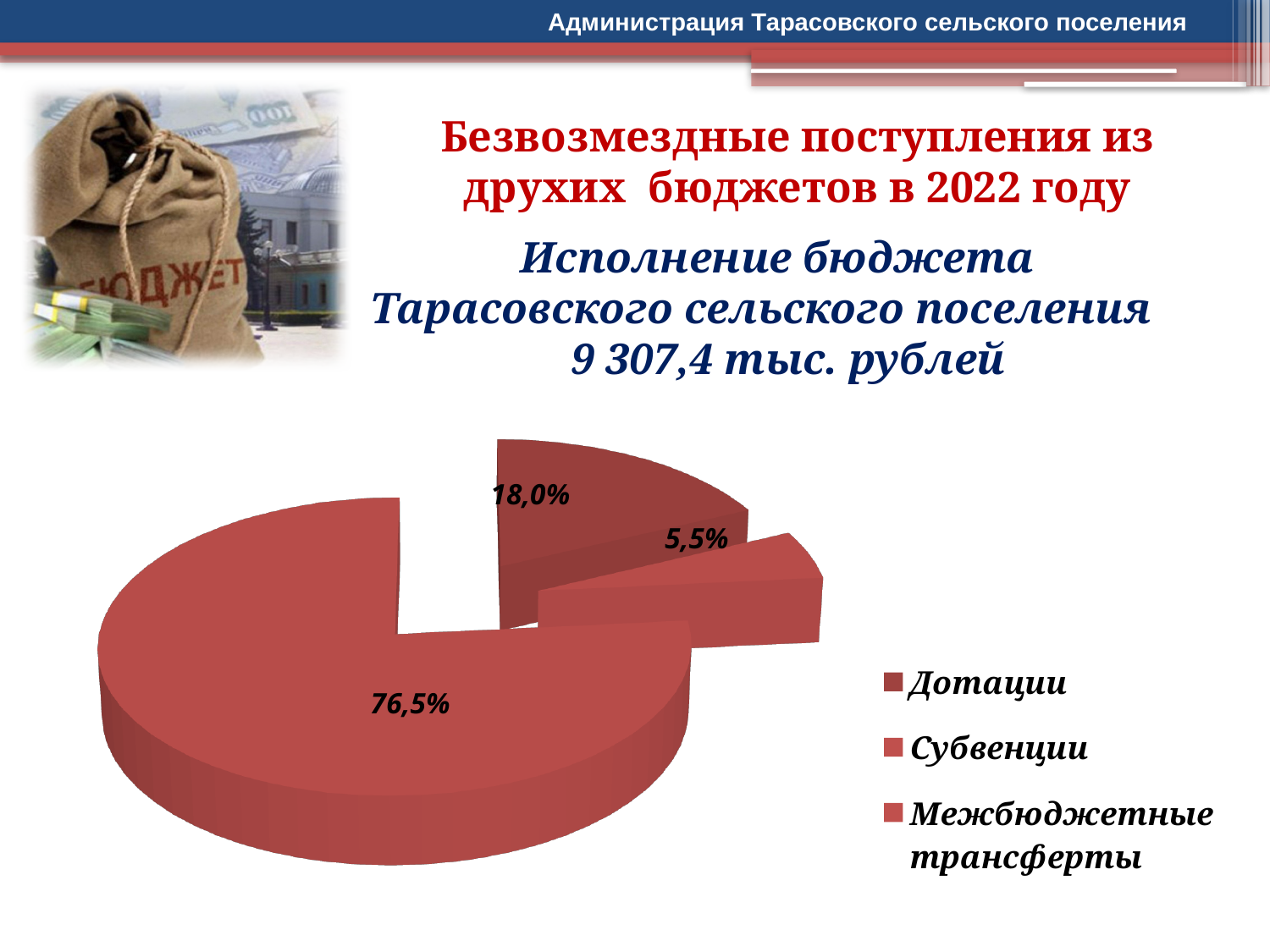
What kind of chart is shown on the slide? pie chart Is the largest slice of the pie chart greater or less than 50%? greater What total amount of budget execution is stated in the slide heading above the chart? 9 307,4 тыс. рублей What is the percentage shown on the smallest slice of the pie chart? 5,5% What is the difference between the largest slice (76,5%) and the 18,0% slice? 58,5% What are the three legend entries of the pie chart? Дотации, Субвенции, Межбюджетные трансферты How many slices does the pie chart have? 3 What do the three percentages on the pie chart add up to? 100% What is the difference between the 18,0% slice and the 5,5% slice? 12,5% How many entries does the legend of the pie chart list? 3 Which is larger: the 18,0% slice or the 5,5% slice? the 18,0% slice What is the percentage shown on the largest slice of the pie chart? 76,5%